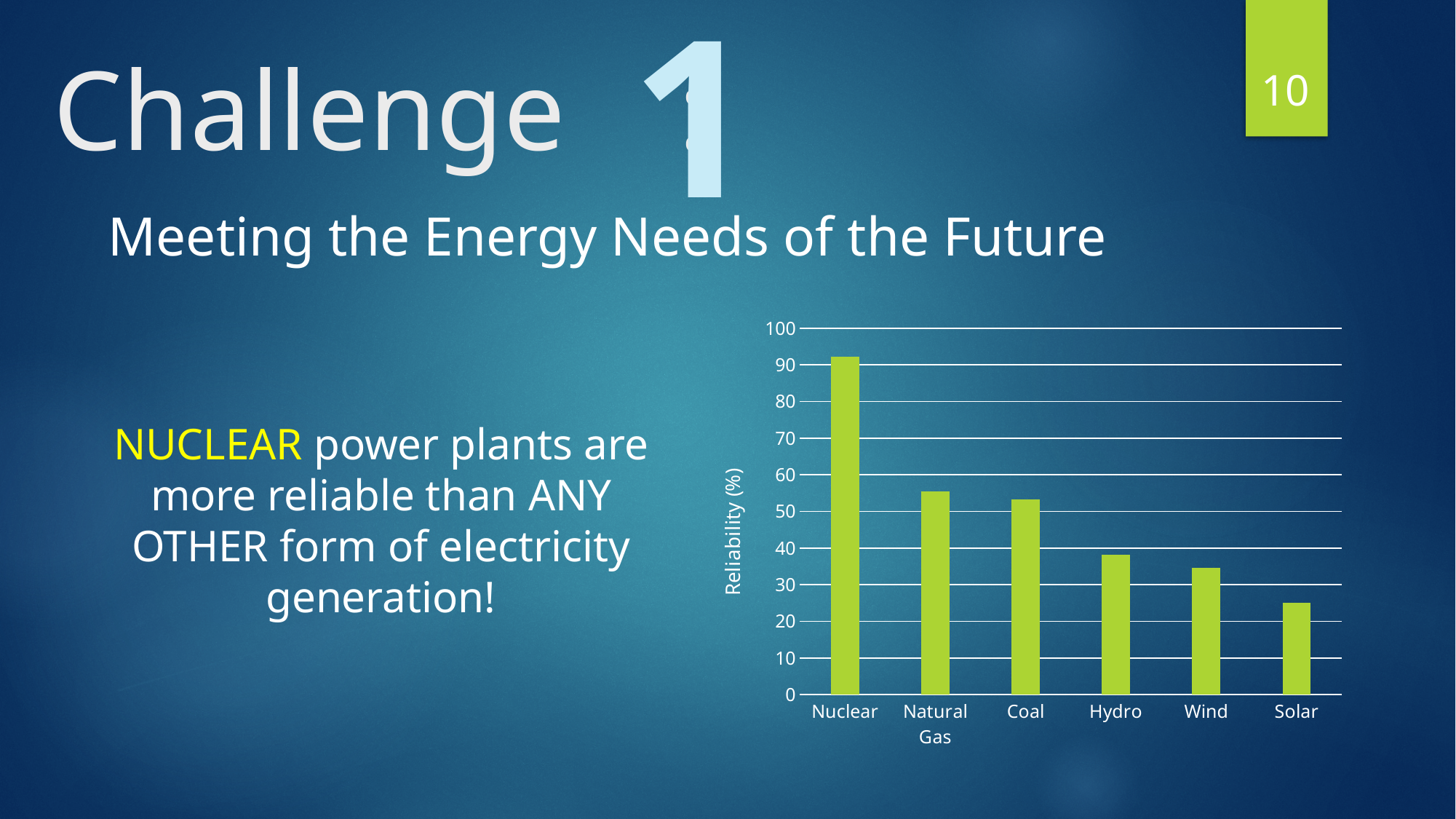
Is the value for Natural Gas greater or less than 50? greater Is the value for Coal greater or less than 60? less What kind of chart is shown on the slide? bar chart What is the label on the vertical axis of the chart? Reliability (%) Is the value for Nuclear greater or less than 80? greater How many categories are shown on the x axis of the chart? 6 Do the values rise or fall moving from Nuclear to Solar along the x axis? fall Which category has the highest reliability in the chart? Nuclear Which category has the lowest reliability in the chart? Solar Which has a higher reliability, Nuclear or Natural Gas? Nuclear